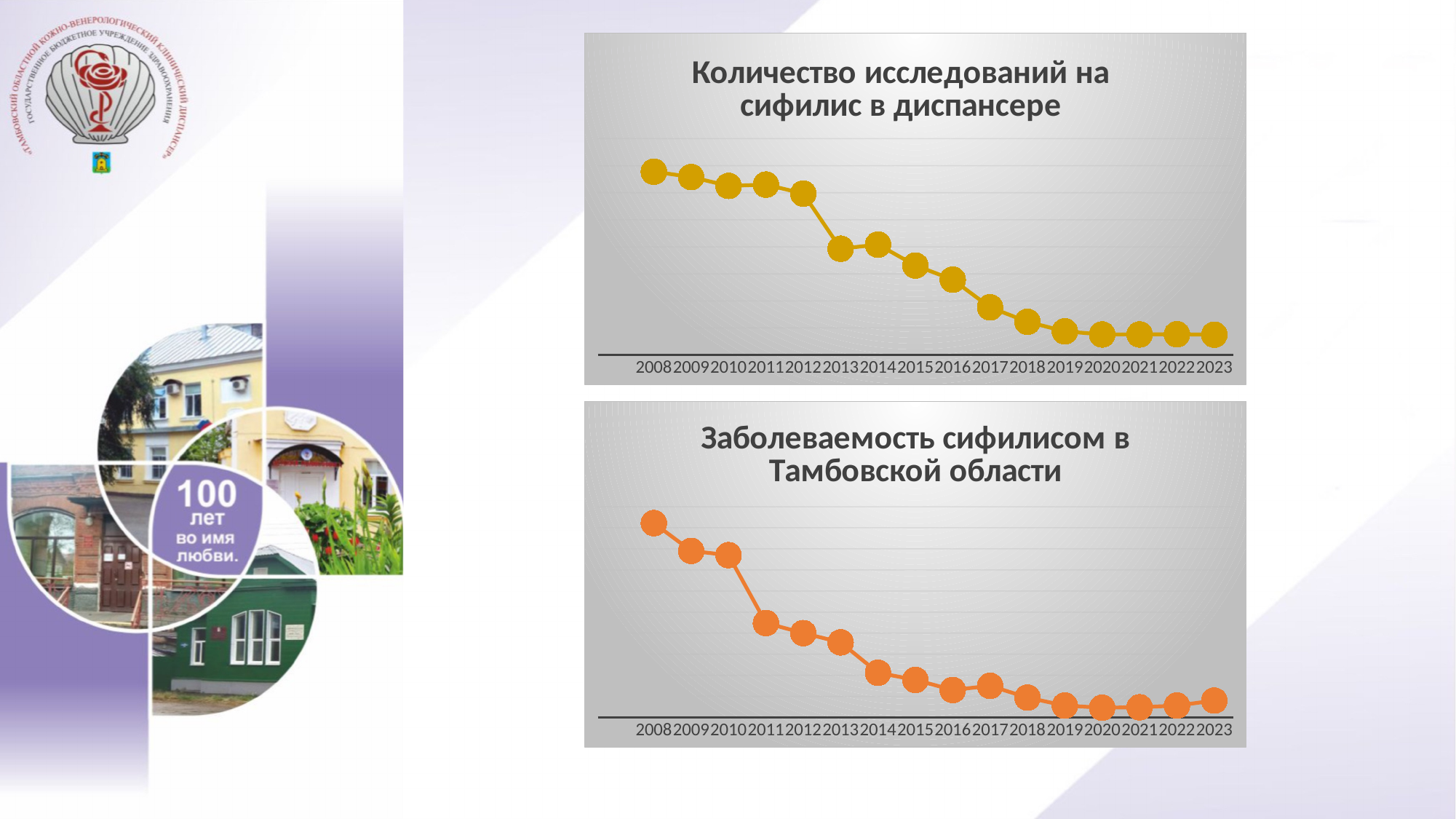
In the top chart, do the values rise or fall from 2008 to 2023? fall In the top chart, which year has the highest value? 2008 What is the title of the top chart? Количество исследований на сифилис в диспансере What type of chart is the top chart titled "Количество исследований на сифилис в диспансере"? line chart What type of chart is the bottom chart titled "Заболеваемость сифилисом в Тамбовской области"? line chart In the bottom chart, which year has the highest value? 2008 In the top chart, how many years are plotted along the x axis? 16 In the bottom chart, how many data points are plotted? 16 In the bottom chart, which year has the larger value, 2010 or 2011? 2010 In the top chart, which year has the larger value, 2012 or 2013? 2012 In the bottom chart, do the values rise or fall from 2008 to 2023? fall What is the first year shown on the x axis of the bottom chart? 2008